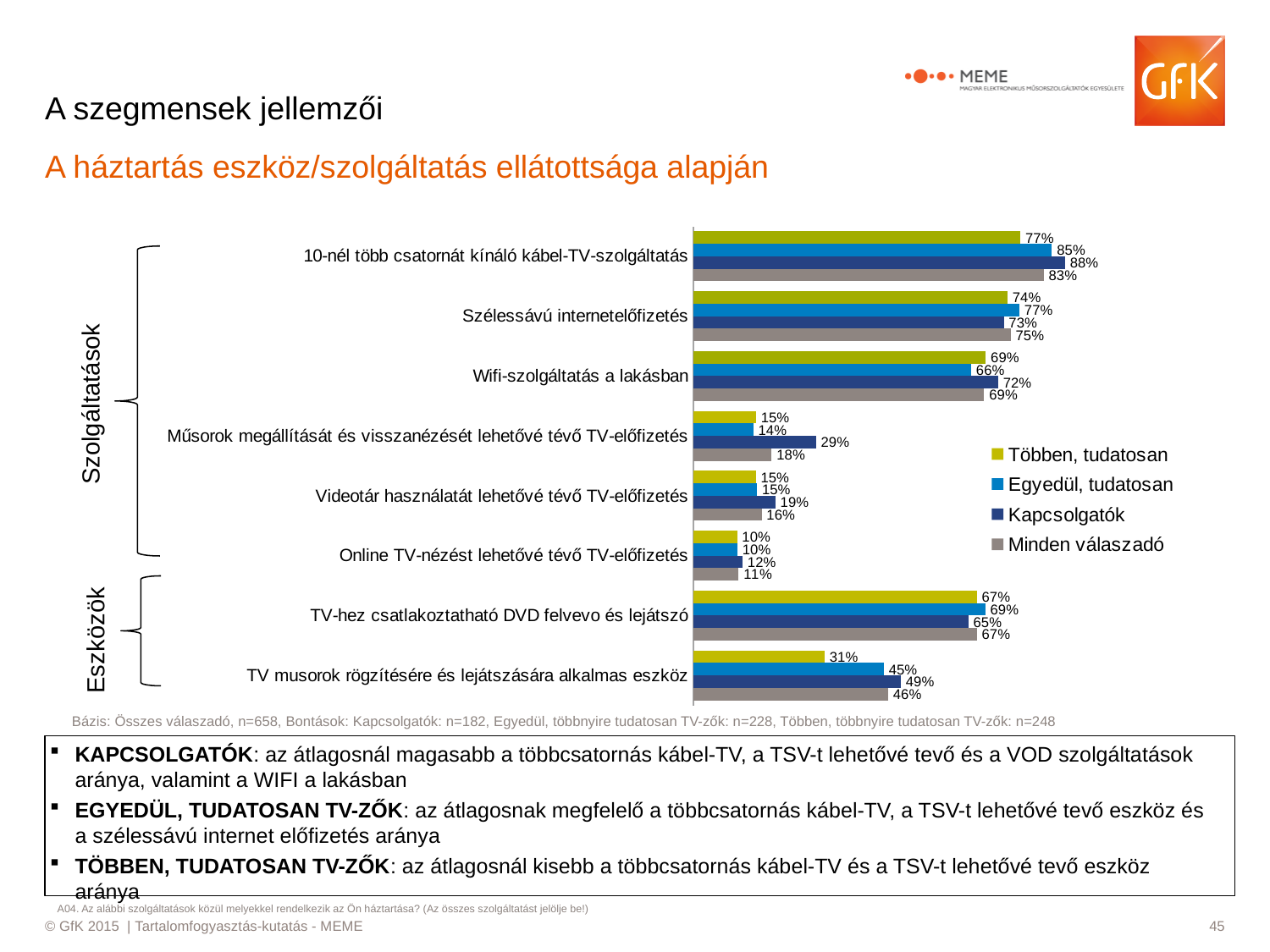
Which legend entry is shown in grey? Minden válaszadó What is the difference between the Egyedül, tudatosan and Többen, tudatosan values in the category '10-nél több csatornát kínáló kábel-TV-szolgáltatás'? 8% What is the value for Többen, tudatosan in the category 'TV musorok rögzítésére és lejátszására alkalmas eszköz'? 31% What kind of chart is shown on the slide? bar chart Which series has the highest value in the category 'Műsorok megállítását és visszanézését lehetővé tévő TV-előfizetés'? Kapcsolgatók In the category 'Wifi-szolgáltatás a lakásban', which is larger: the value for Kapcsolgatók or the value for Egyedül, tudatosan? Kapcsolgatók How many series does the legend list? 4 How many categories are plotted on the chart? 8 Which category has the lowest value for Minden válaszadó? Online TV-nézést lehetővé tévő TV-előfizetés What is the value for Kapcsolgatók in the category '10-nél több csatornát kínáló kábel-TV-szolgáltatás'? 88% What is the value for Minden válaszadó in the category 'Szélessávú internetelőfizetés'? 75% What is the difference between the Kapcsolgatók and Többen, tudatosan values in the category 'TV musorok rögzítésére és lejátszására alkalmas eszköz'? 18%